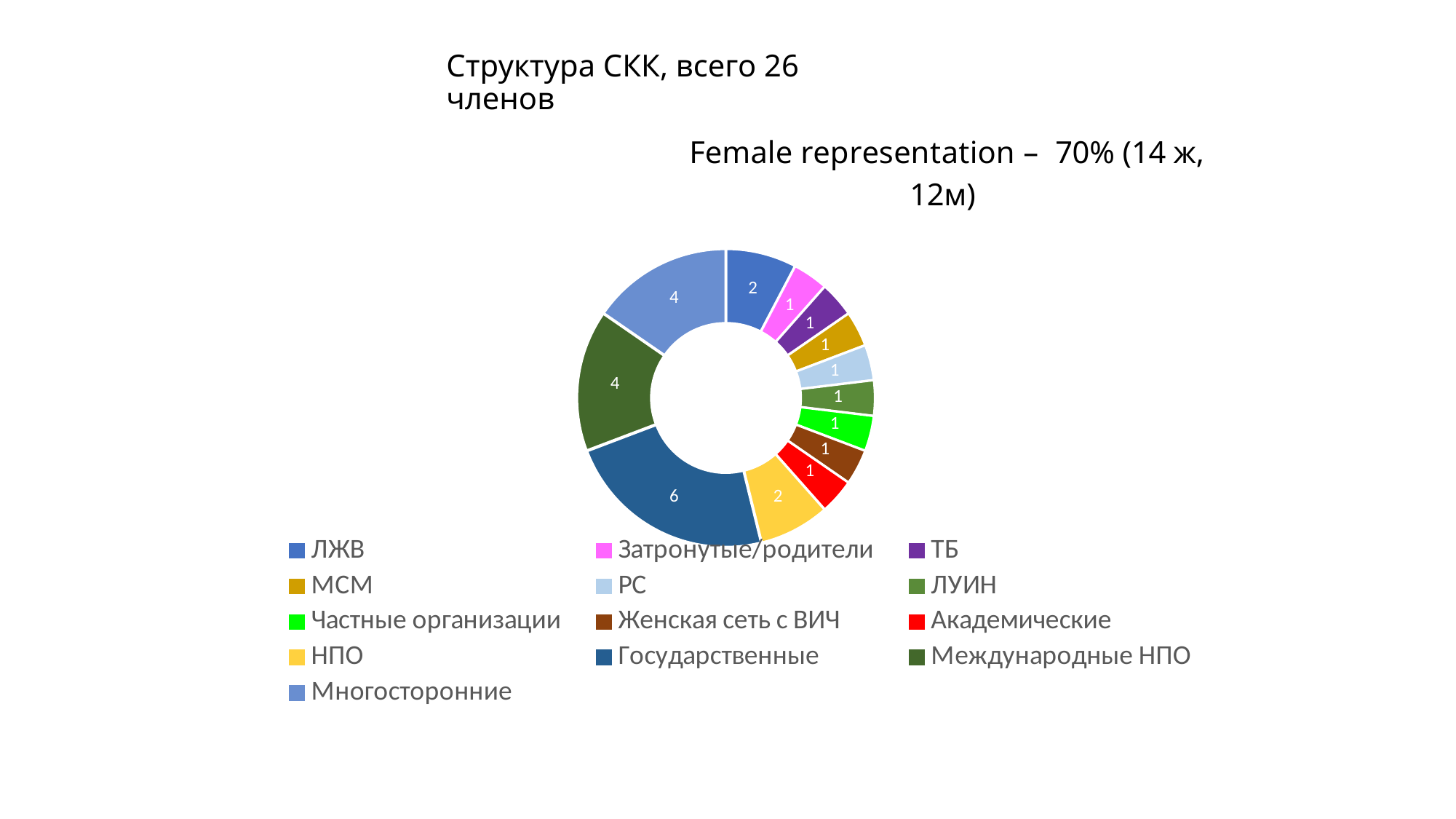
Which category has the largest slice? Государственные What type of chart is shown on the slide? Doughnut (pie) chart What is the value for ЛЖВ? 2 What is the total of all slices in the chart? 26 What is the value for Международные НПО? 4 What is the difference between the values for Государственные and Многосторонние? 2 What is the value for ТБ? 1 Which is larger, the value for НПО or the value for Международные НПО? Международные НПО What is the title of the chart? Структура СКК, всего 26 членов What is the value for Государственные? 6 How many categories does the legend list? 13